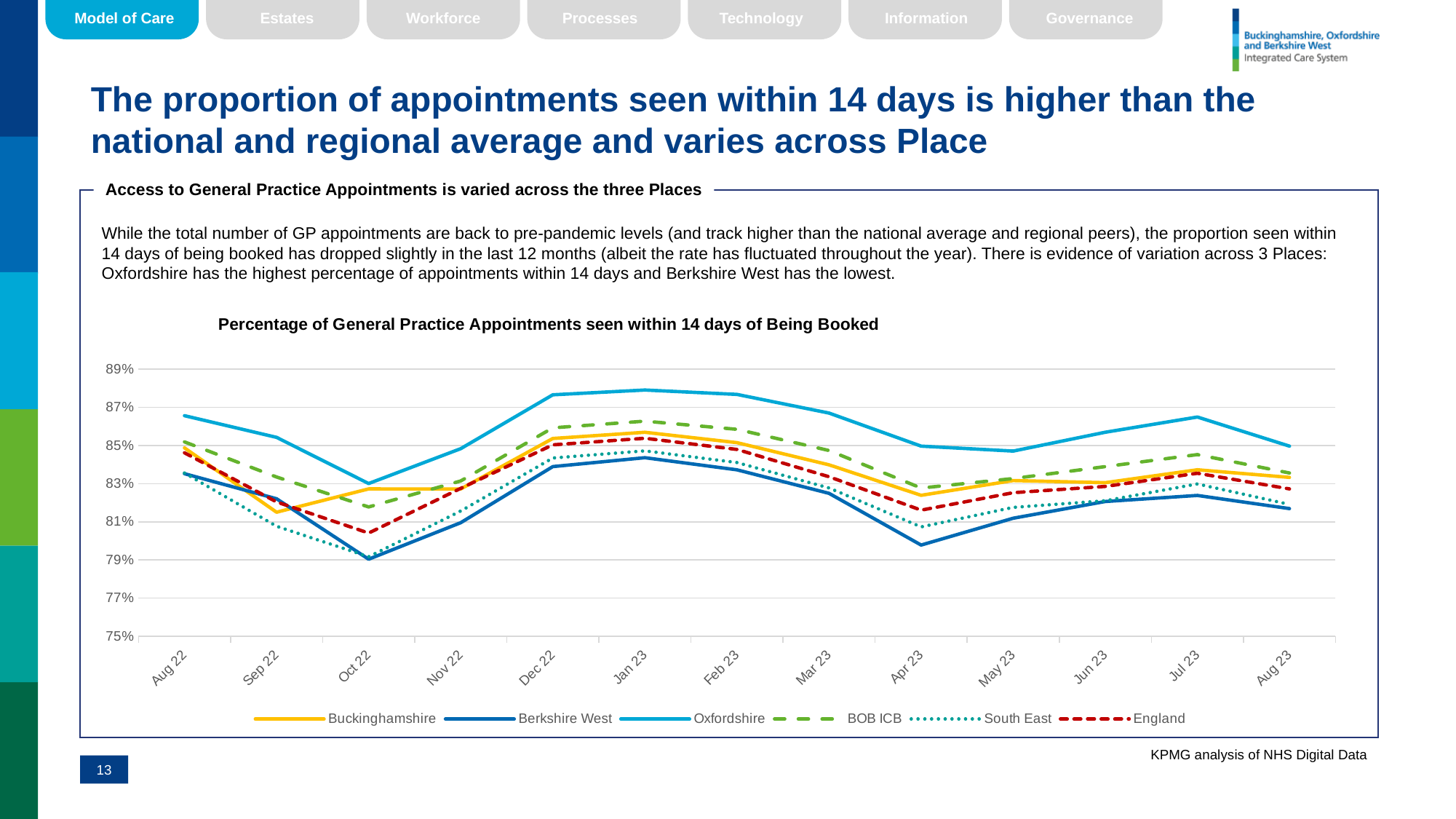
What kind of chart is shown on the slide? Line chart Which series is plotted with a red dashed line? England Does the Oxfordshire line rise or fall from Aug 22 to Oct 22? Fall Which series has the highest value in Jan 23? Oxfordshire Is the value for Berkshire West in Apr 23 greater or less than 81%? less How many series does the chart legend list? 6 Is the value for South East in Oct 22 greater or less than 81%? less Is the value for Oxfordshire in Jan 23 greater or less than 87%? greater In Dec 22, which is larger: the value for Oxfordshire or the value for Berkshire West? Oxfordshire What is the title of the chart? Percentage of General Practice Appointments seen within 14 days of Being Booked How many months are plotted along the x axis of the chart? 13 Which series has the lowest value in Apr 23? Berkshire West